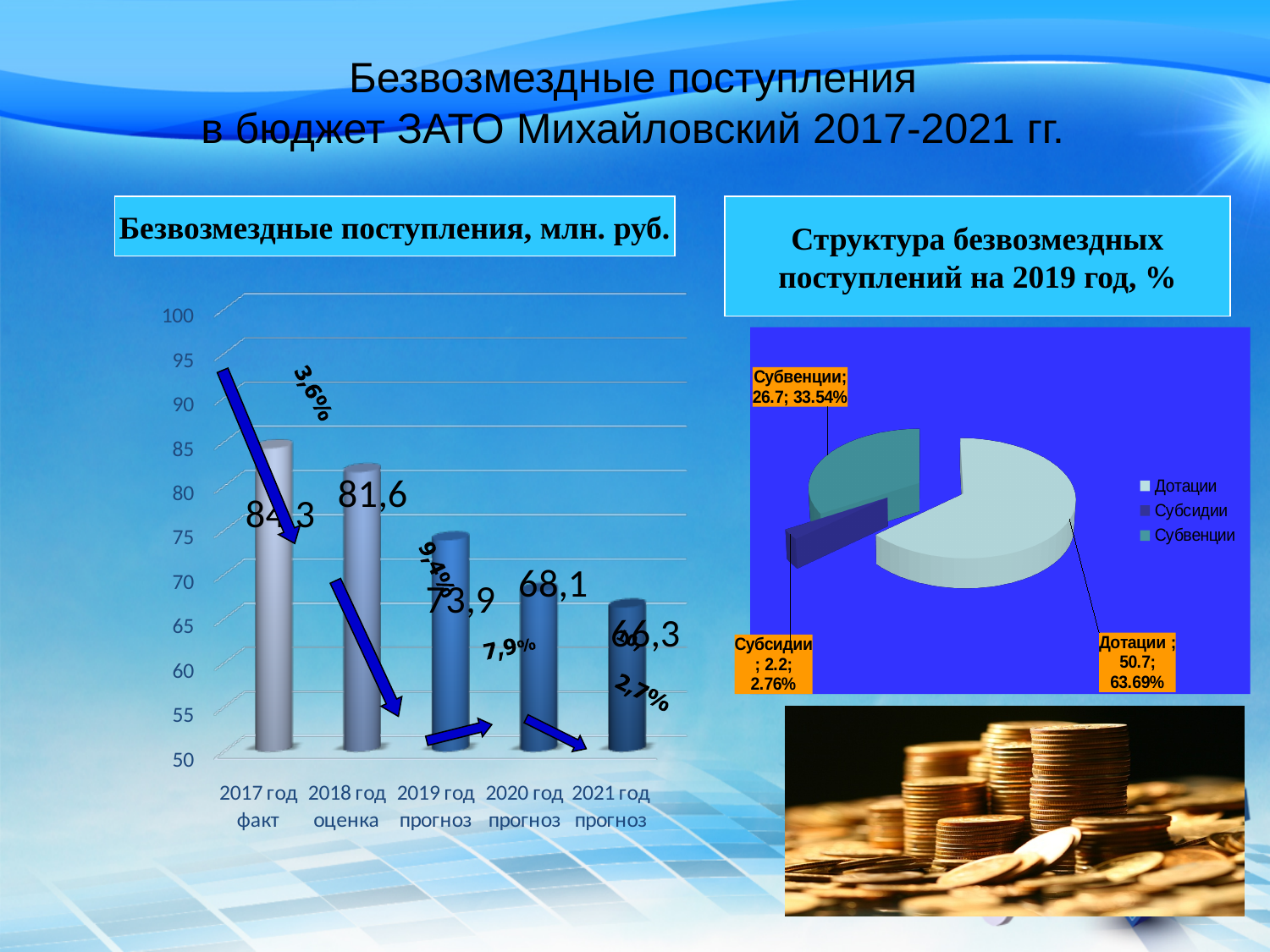
On the pie chart 'Структура безвозмездных поступлений на 2019 год, %', what is the value shown for Субвенции? 26.7 On the bar chart 'Безвозмездные поступления, млн. руб.', what is the value for 2017 год факт? 84,3 On the bar chart 'Безвозмездные поступления, млн. руб.', how many bars are plotted? 5 On the bar chart 'Безвозмездные поступления, млн. руб.', which year has the highest value? 2017 год факт On the pie chart 'Структура безвозмездных поступлений на 2019 год, %', which slice is the smallest? Субсидии On the bar chart 'Безвозмездные поступления, млн. руб.', what is the difference between the 2018 год оценка value and the 2020 год прогноз value? 13,5 On the bar chart 'Безвозмездные поступления, млн. руб.', which year has the lowest value? 2021 год прогноз On the pie chart 'Структура безвозмездных поступлений на 2019 год, %', what share does Дотации have? 63.69% On the bar chart 'Безвозмездные поступления, млн. руб.', what is the value for 2021 год прогноз? 66,3 On the bar chart 'Безвозмездные поступления, млн. руб.', do the values rise or fall from 2017 to 2021? fall On the bar chart 'Безвозмездные поступления, млн. руб.', what is the value for 2019 год прогноз? 73,9 What kind of chart is 'Структура безвозмездных поступлений на 2019 год, %'? pie chart